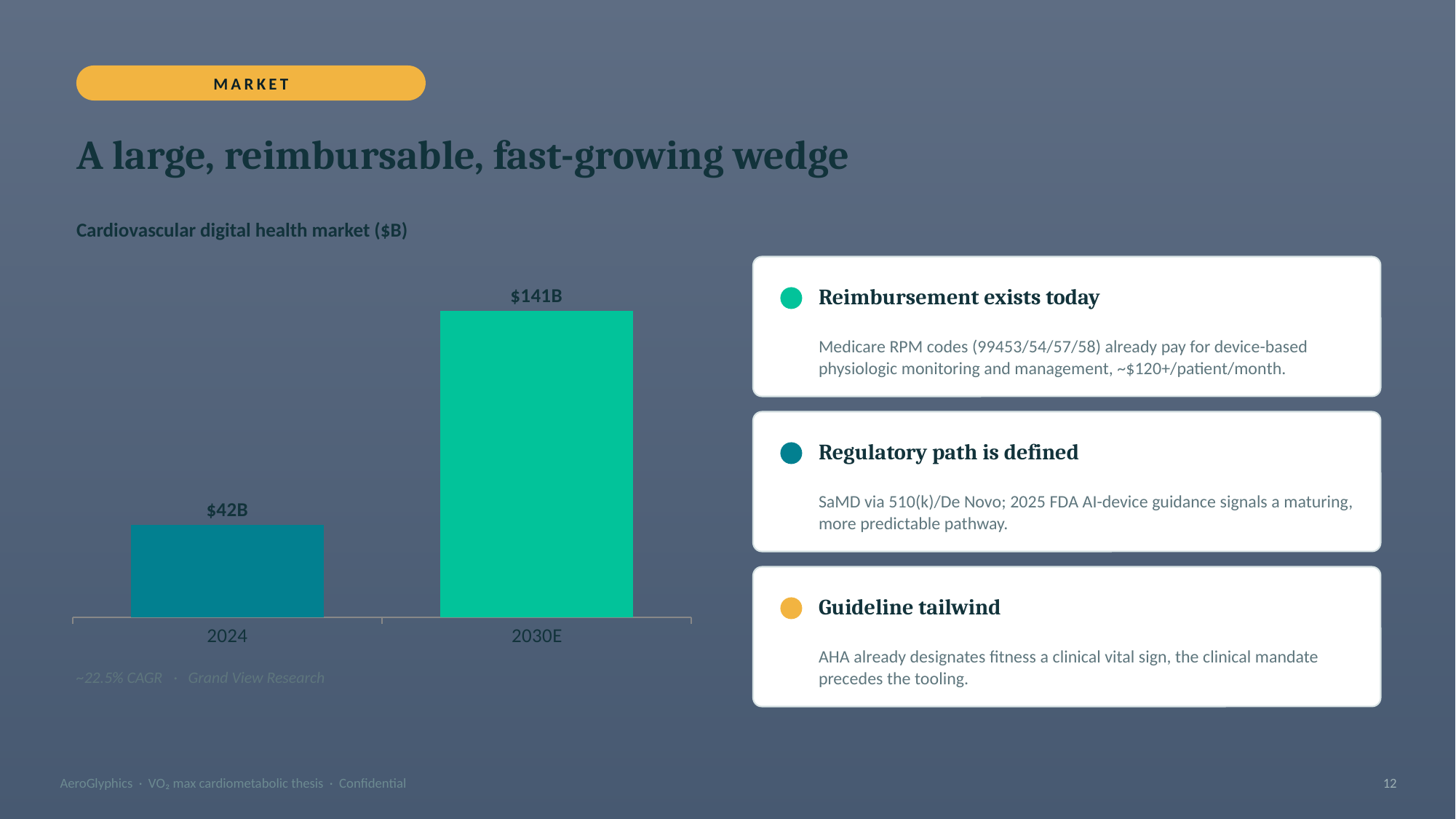
What CAGR is noted beneath the chart? ~22.5% CAGR What is the difference between the 2030E and 2024 values in the chart? $99B How many categories are plotted in the chart? 2 Which category has the highest value in the chart? 2030E Which is larger in the chart, the value for 2024 or the value for 2030E? 2030E What is the value for 2024 in the Cardiovascular digital health market chart? $42B What is the value for 2030E in the Cardiovascular digital health market chart? $141B What kind of chart is shown on the slide? Bar chart What is the title of the chart on the slide? Cardiovascular digital health market ($B) Do the values in the chart rise or fall from 2024 to 2030E? Rise Which category has the lowest value in the chart? 2024